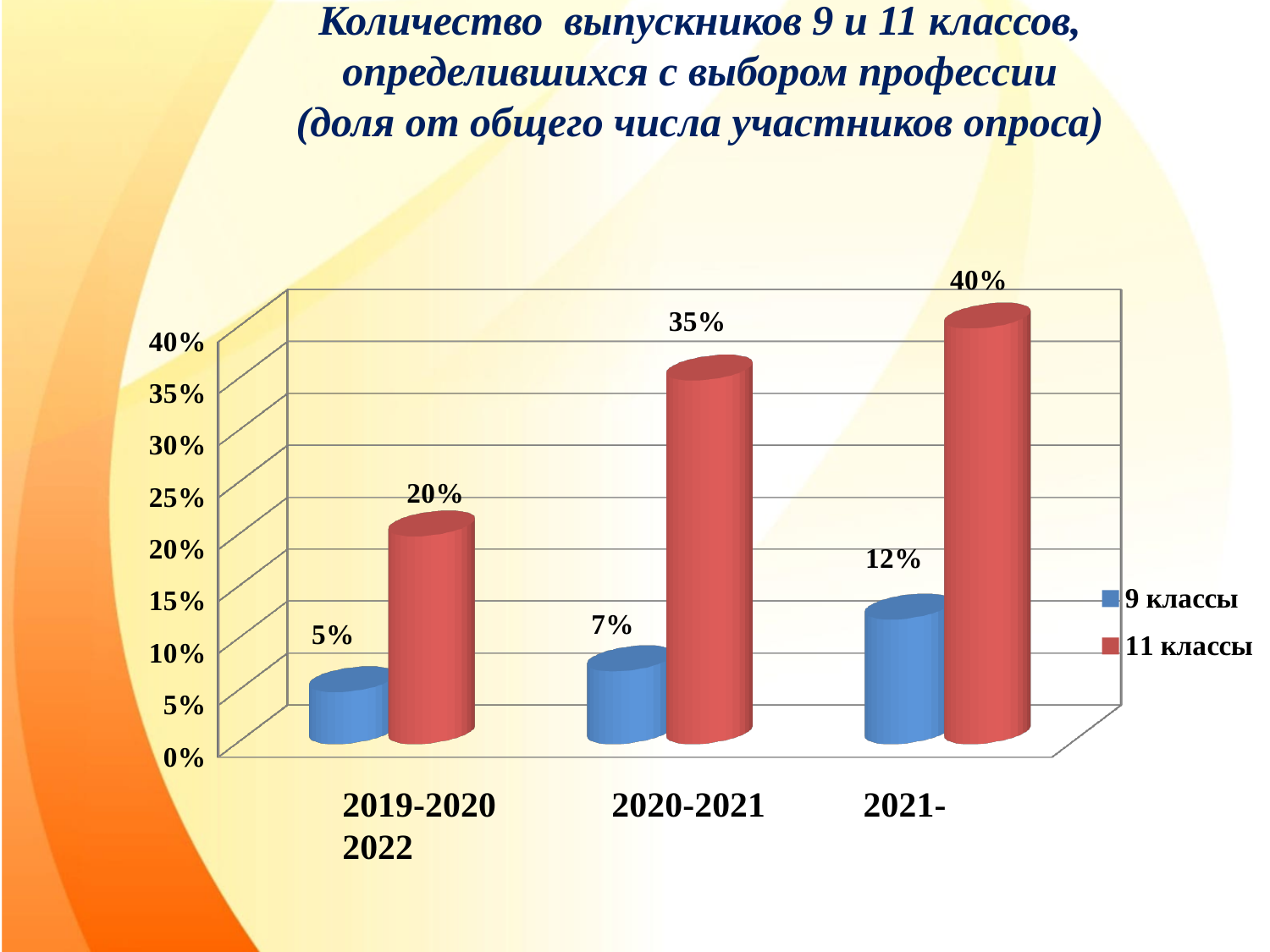
Which is larger in 2020-2021: 9 классы or 11 классы? 11 классы How many year categories are shown on the x axis? 3 Which year has the lowest value for 9 классы? 2019-2020 What is the value for 9 классы in 2019-2020? 5% Is the value for 11 классы in 2019-2020 greater or less than 15%? greater How many series does the legend list? 2 What is the value for 9 классы in 2021-2022? 12% Which year has the highest value for 11 классы? 2021-2022 Do the values for 9 классы rise or fall from 2019-2020 to 2021-2022? rise What kind of chart is shown on the slide? bar chart What is the value for 11 классы in 2020-2021? 35% What is the difference between 11 классы and 9 классы in 2021-2022? 28%